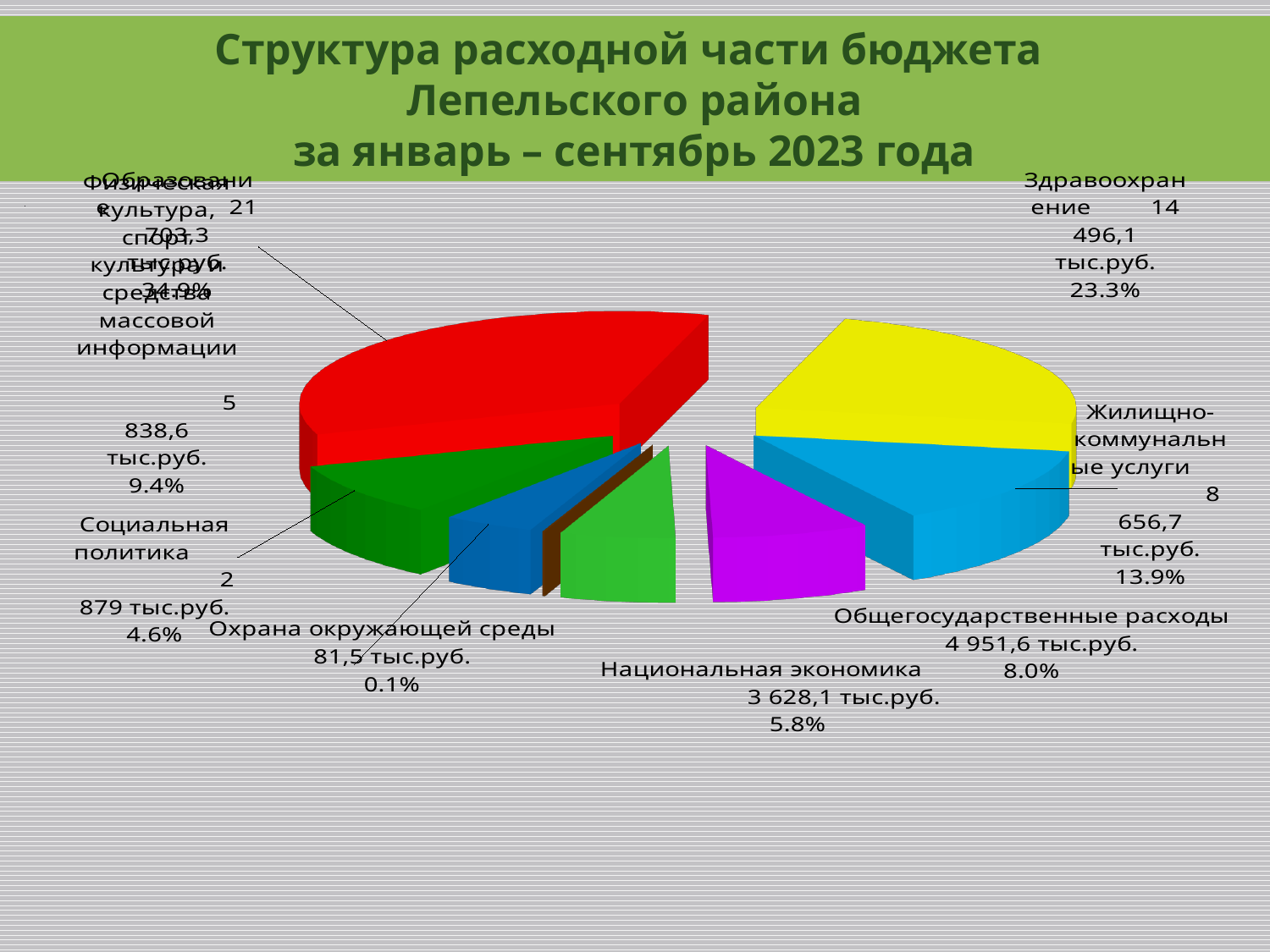
How many slices does the pie chart have? 8 What share of expenditure goes to Здравоохранение? 23.3% Which has a larger share: Социальная политика or Национальная экономика? Национальная экономика What period does the chart title say the budget structure covers? январь – сентябрь 2023 года By how many percentage points does the share of Здравоохранение exceed that of Жилищно-коммунальные услуги? 9.4 What share of expenditure goes to Общегосударственные расходы? 8.0% What is the amount spent on Национальная экономика? 3 628,1 тыс.руб. Which category has the largest share of the budget expenditure? Образование Which category has the smallest share of the budget expenditure? Охрана окружающей среды What is the amount spent on Жилищно-коммунальные услуги? 8 656,7 тыс.руб. What kind of chart is shown on the slide? pie chart What is the amount spent on Охрана окружающей среды? 81,5 тыс.руб.